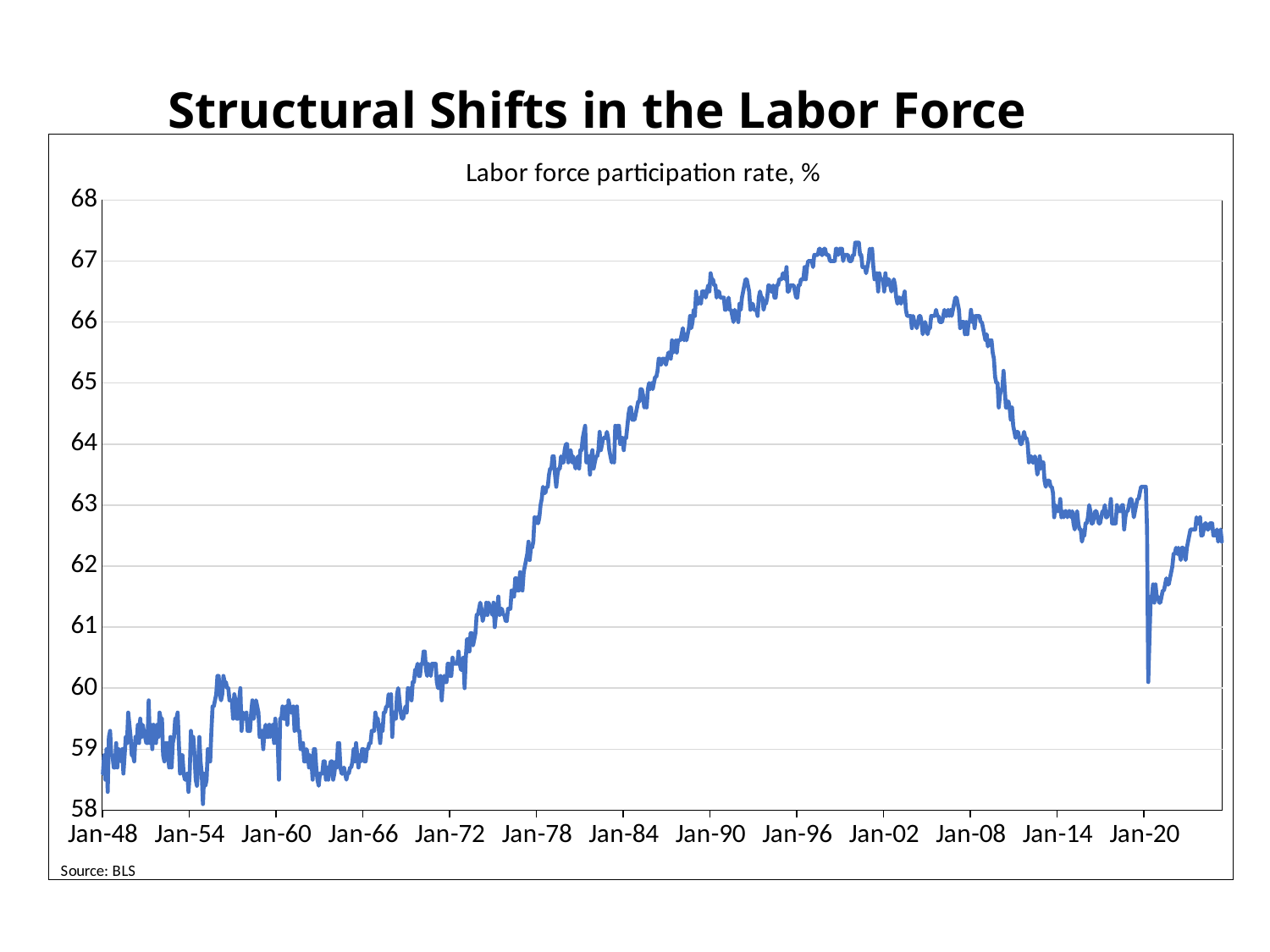
What source is cited for the chart data? BLS Is the labor force participation rate at Jan-48 greater or less than 60? less Is the labor force participation rate around Jan-08 greater or less than 65? greater How many year labels are shown on the x axis? 13 Does the labor force participation rate rise or fall between Jan-02 and Jan-14? fall What kind of chart is shown on the slide? Line chart Is the labor force participation rate around Jan-14 greater or less than 64? less What is the title of the chart? Labor force participation rate, % Does the labor force participation rate rise or fall between Jan-66 and Jan-90? rise Between which two x-axis labels does the line reach its highest point? Jan-96 and Jan-02